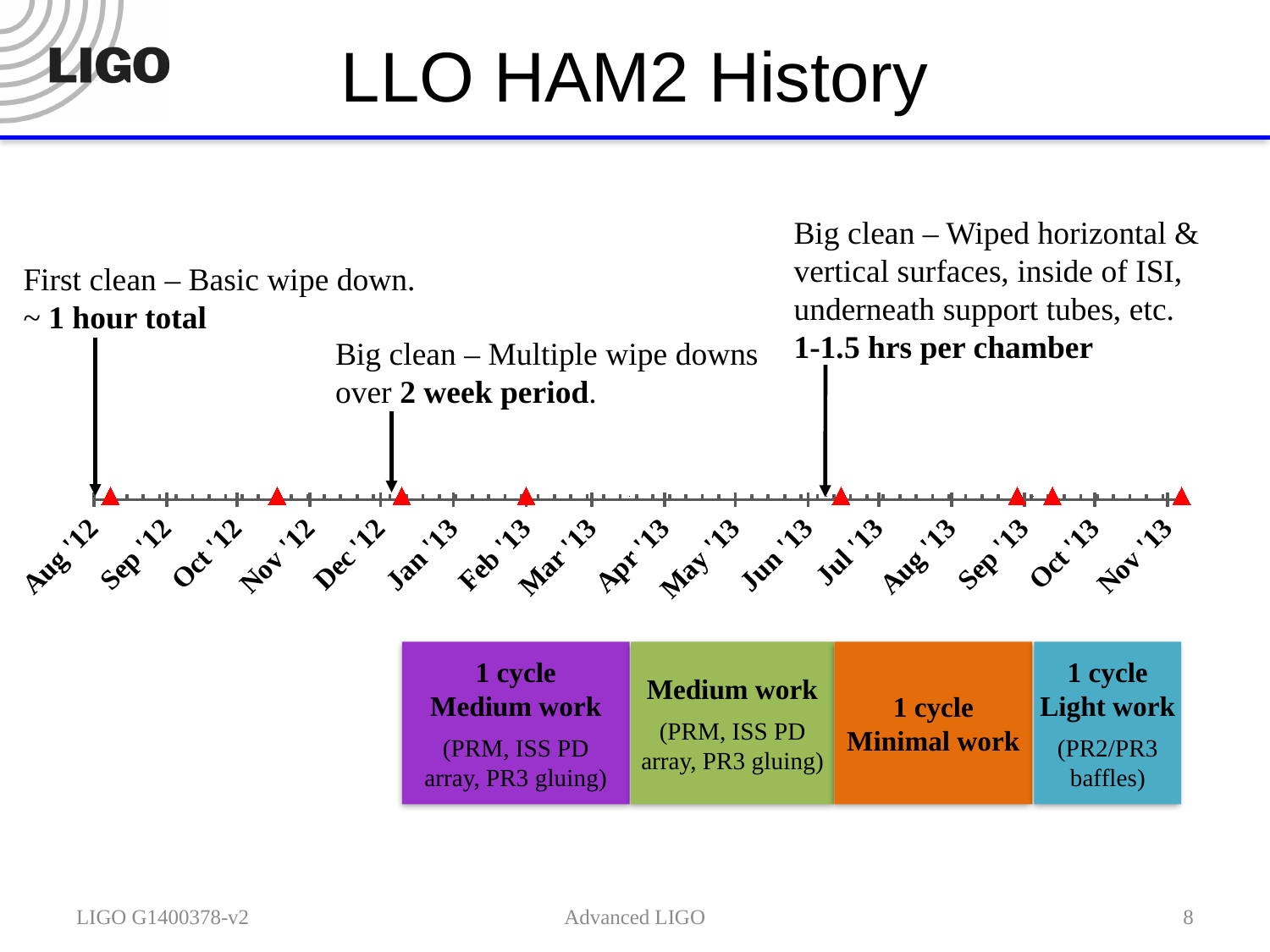
How many coloured work-cycle boxes are shown below the timeline? 4 In which month is the first clean marked on the timeline? Aug '12 According to the annotation, how long did the first clean (basic wipe down) take in total? ~ 1 hour total What work is listed in the blue box below the timeline? 1 cycle Light work (PR2/PR3 baffles) What kind of chart is shown on the slide? Timeline What is the title of the slide? LLO HAM2 History What is the first month label on the timeline? Aug '12 How many red triangle markers are on the timeline? 8 How many month labels are shown along the timeline axis? 16 What is the last month label on the timeline? Nov '13 How many hours per chamber did the big clean around Jul '13 take? 1-1.5 hrs per chamber Over what period were the multiple wipe downs of the big clean around Dec '12 carried out? 2 week period